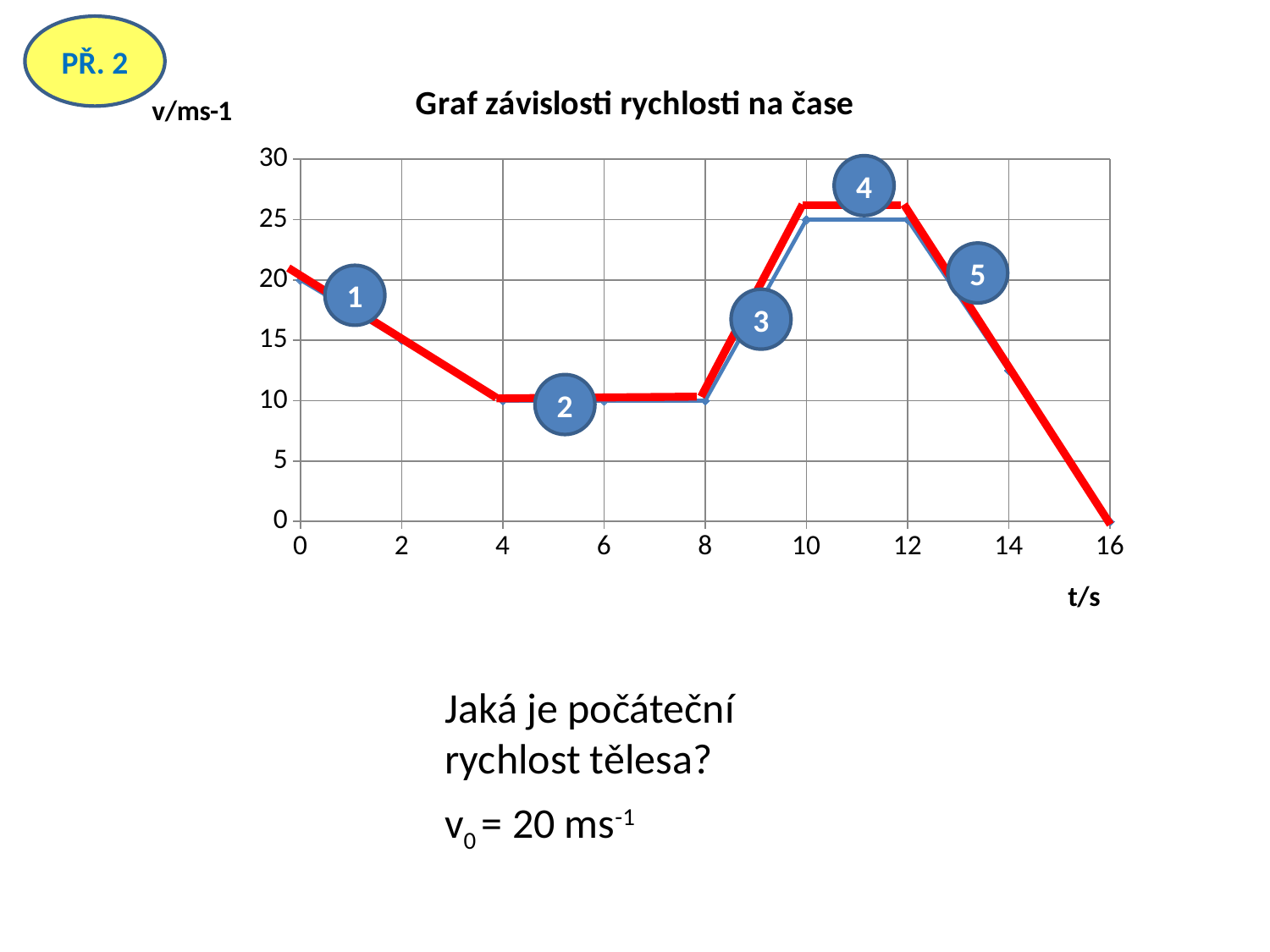
At what time does the velocity reach its lowest value on the chart? 16 What is the label of the horizontal axis of the chart? t/s What kind of chart is shown on the slide? line chart Does the velocity rise or fall between t = 0 s and t = 4 s? fall What is the velocity v at time t = 16 s according to the chart? 0 What is the highest velocity value reached on the chart? 25 By how much does the velocity increase between t = 8 s and t = 10 s? 15 How many numbered segment markers (blue circles) are placed on the chart? 5 What is the velocity v at time t = 0 s according to the chart? 20 What is the velocity v at time t = 10 s according to the chart? 25 What is the velocity v at time t = 4 s according to the chart? 10 What is the title of the chart? Graf závislosti rychlosti na čase